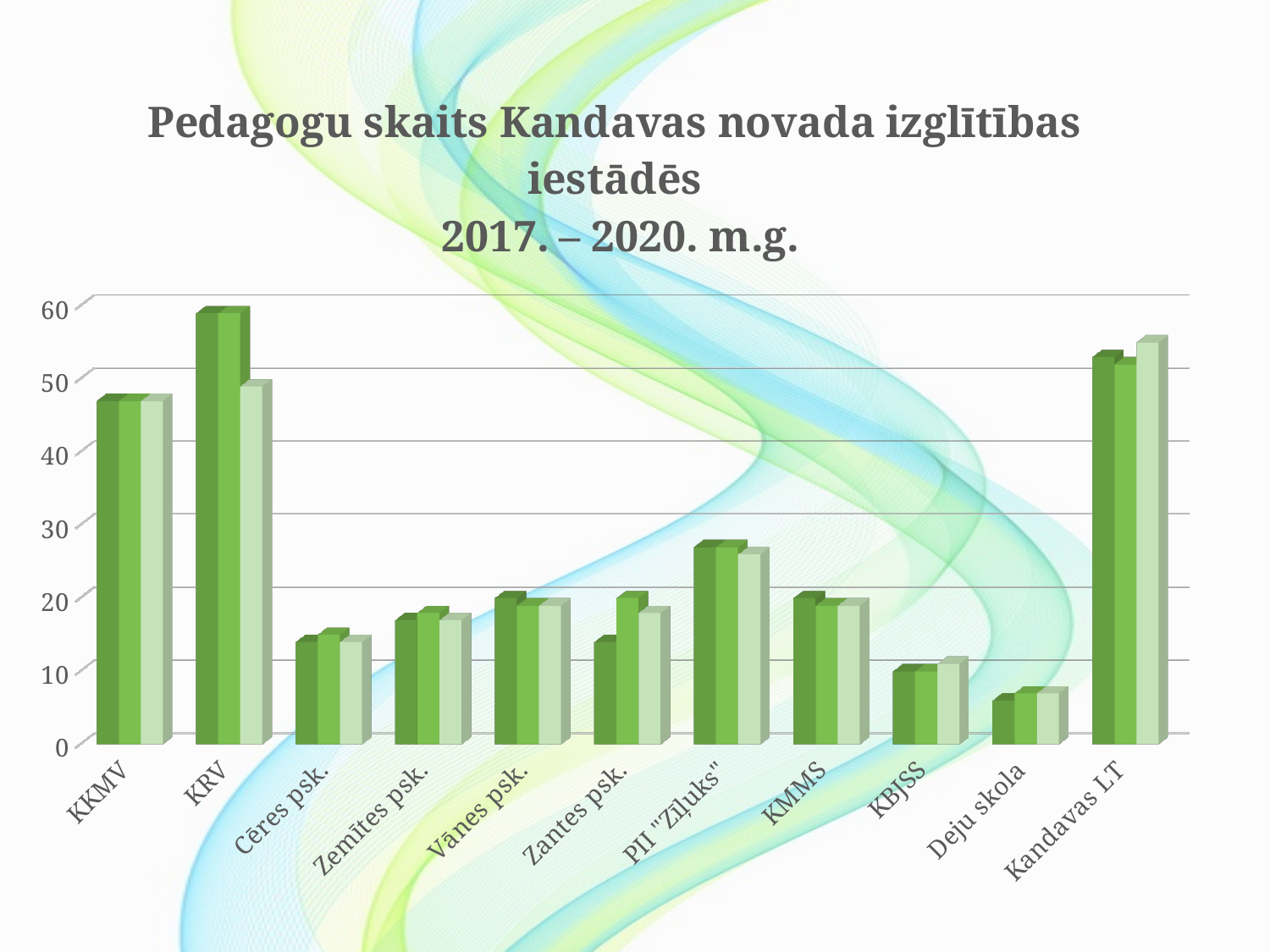
Are the values for Deju skola greater or less than 10? less Are the values for PII "Zīļuks" greater or less than 30? less How many institutions (categories) are shown on the x axis of the chart? 11 Which has the taller first (darkest) bar, KRV or KKMV? KRV Are the values for Kandavas LT greater or less than 50? greater What is the title of the chart? Pedagogu skaits Kandavas novada izglītības iestādēs 2017. – 2020. m.g. What kind of chart is shown on the slide? bar chart Which institution has taller bars, Kandavas LT or PII "Zīļuks"? Kandavas LT Which institution has the tallest bar in the chart? KRV Which institution has the lowest bars in the chart? Deju skola